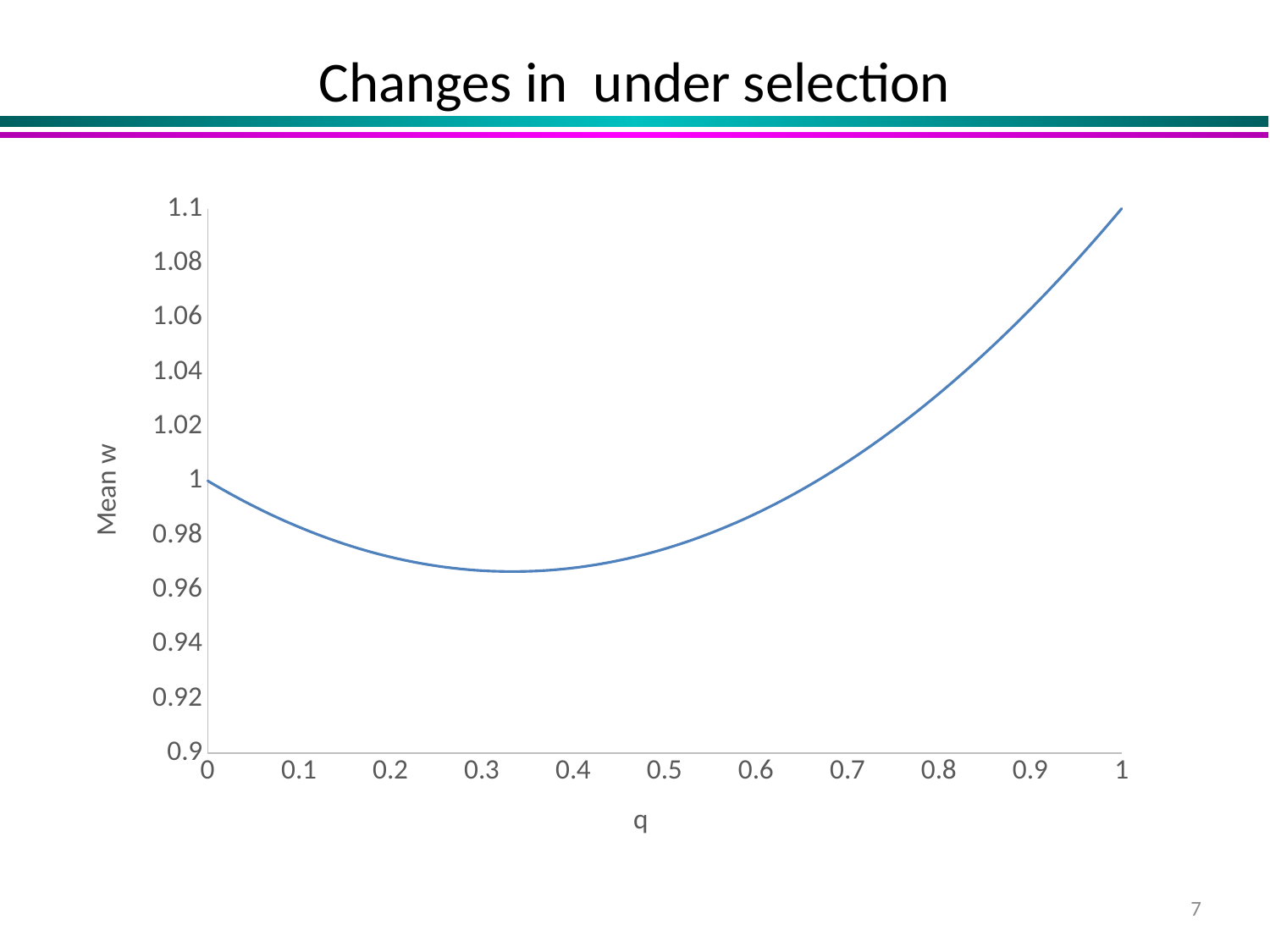
How does Mean w change as q increases from 0 to 1? It falls first, then rises Is the value of Mean w at q = 0.5 greater or less than 1? less What is the value of Mean w at q = 0? 1 Is the value of Mean w at q = 0.3 greater or less than 0.98? less What kind of chart is shown on the slide? line chart What is the label of the x axis? q Is the value of Mean w at q = 0.9 greater or less than 1.04? greater Is Mean w larger at q = 0 or at q = 1? q = 1 At which value of q is Mean w highest? 1 What is the label of the y axis? Mean w What is the value of Mean w at q = 1? 1.1